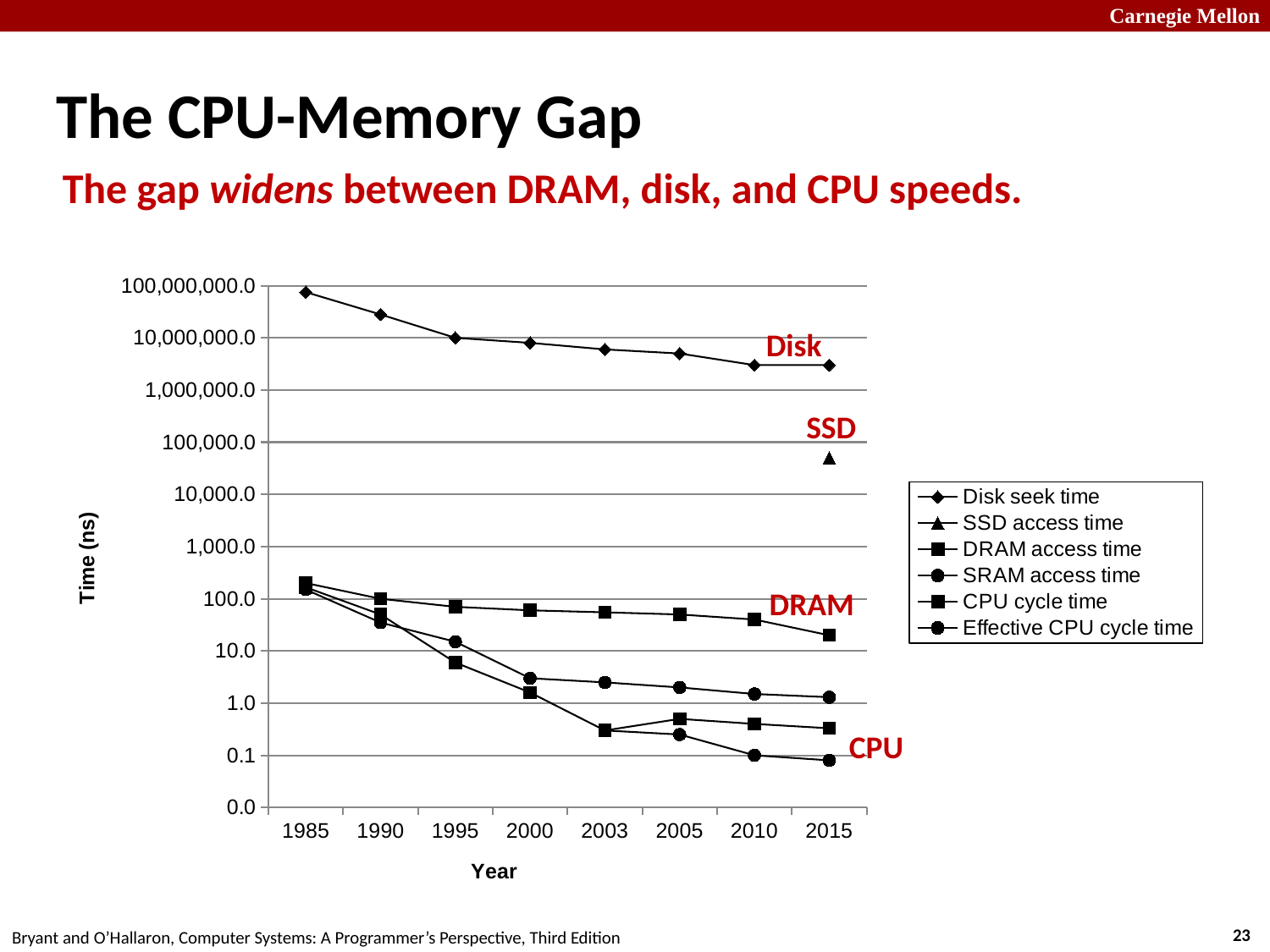
Is the Disk seek time in 2015 greater or less than 10,000,000.0? less Is the SRAM access time in 2015 greater or less than 10.0? less Is the SSD access time in 2015 greater or less than 100,000.0? less Which series has the highest value in 1985? Disk seek time What is the label on the y axis? Time (ns) Does the Disk seek time rise or fall from 1985 to 2015? fall How many years are plotted along the x axis? 8 How many series does the legend list? 6 What kind of chart is shown on the slide? line chart Which is larger in 2015, the Disk seek time or the DRAM access time? Disk seek time